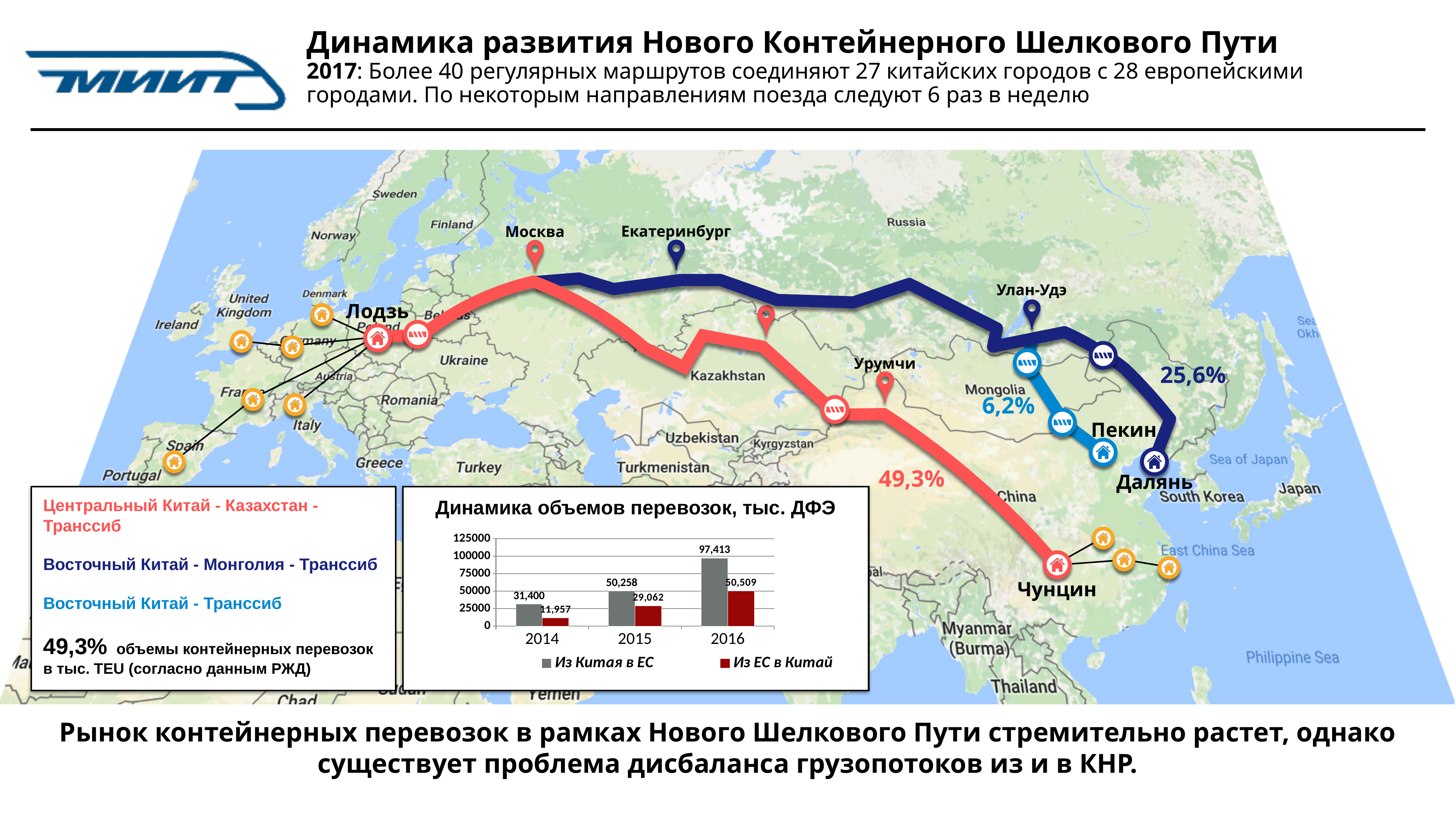
How many years are shown on the x axis of the chart? 3 What is the value for "Из ЕС в Китай" in 2015? 29,062 How many series does the chart legend list? 2 In which year is the value for "Из ЕС в Китай" lowest? 2014 What is the difference between "Из Китая в ЕС" and "Из ЕС в Китай" in 2016? 46,904 Do the values for "Из Китая в ЕС" rise or fall from 2014 to 2016? Rise What is the value for "Из ЕС в Китай" in 2014? 11,957 What kind of chart is shown on the slide? Bar chart Which is larger in 2015: "Из Китая в ЕС" or "Из ЕС в Китай"? Из Китая в ЕС In which year is the value for "Из Китая в ЕС" highest? 2016 What is the value for "Из Китая в ЕС" in 2015? 50,258 What is the value for "Из Китая в ЕС" in 2016? 97,413